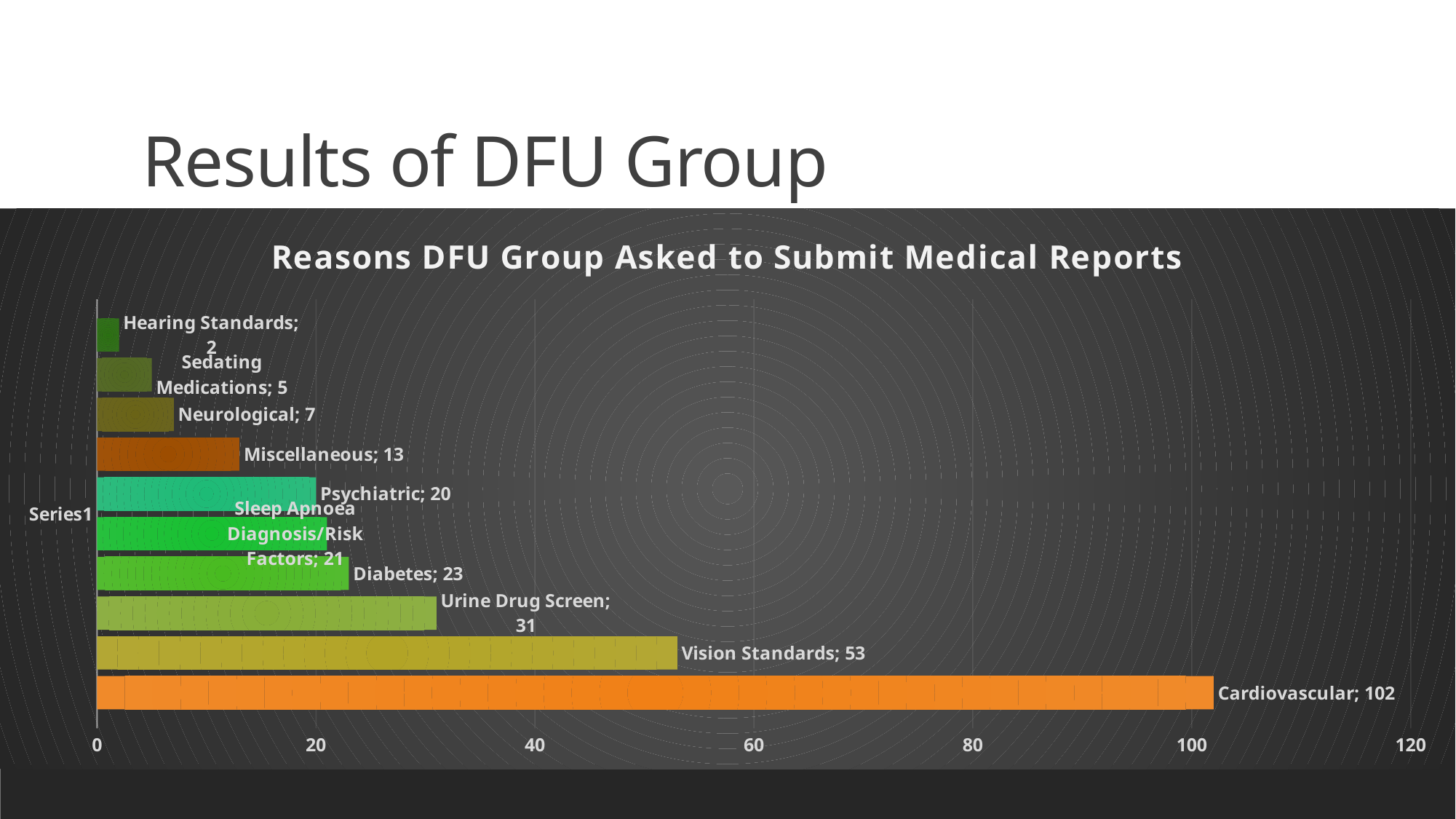
Which category has the highest value? Cardiovascular How many categories are shown in the chart? 10 What is the value for Vision Standards? 53 What is the difference between the values for Cardiovascular and Vision Standards? 49 What is the title of the chart? Reasons DFU Group Asked to Submit Medical Reports What kind of chart is shown on the slide? Bar chart What is the value for Urine Drug Screen? 31 What is the value for Cardiovascular? 102 Which is larger, the value for Miscellaneous or the value for Neurological? Miscellaneous What is the value for Sleep Apnoea Diagnosis/Risk Factors? 21 What is the difference between the values for Diabetes and Psychiatric? 3 Which category has the lowest value? Hearing Standards